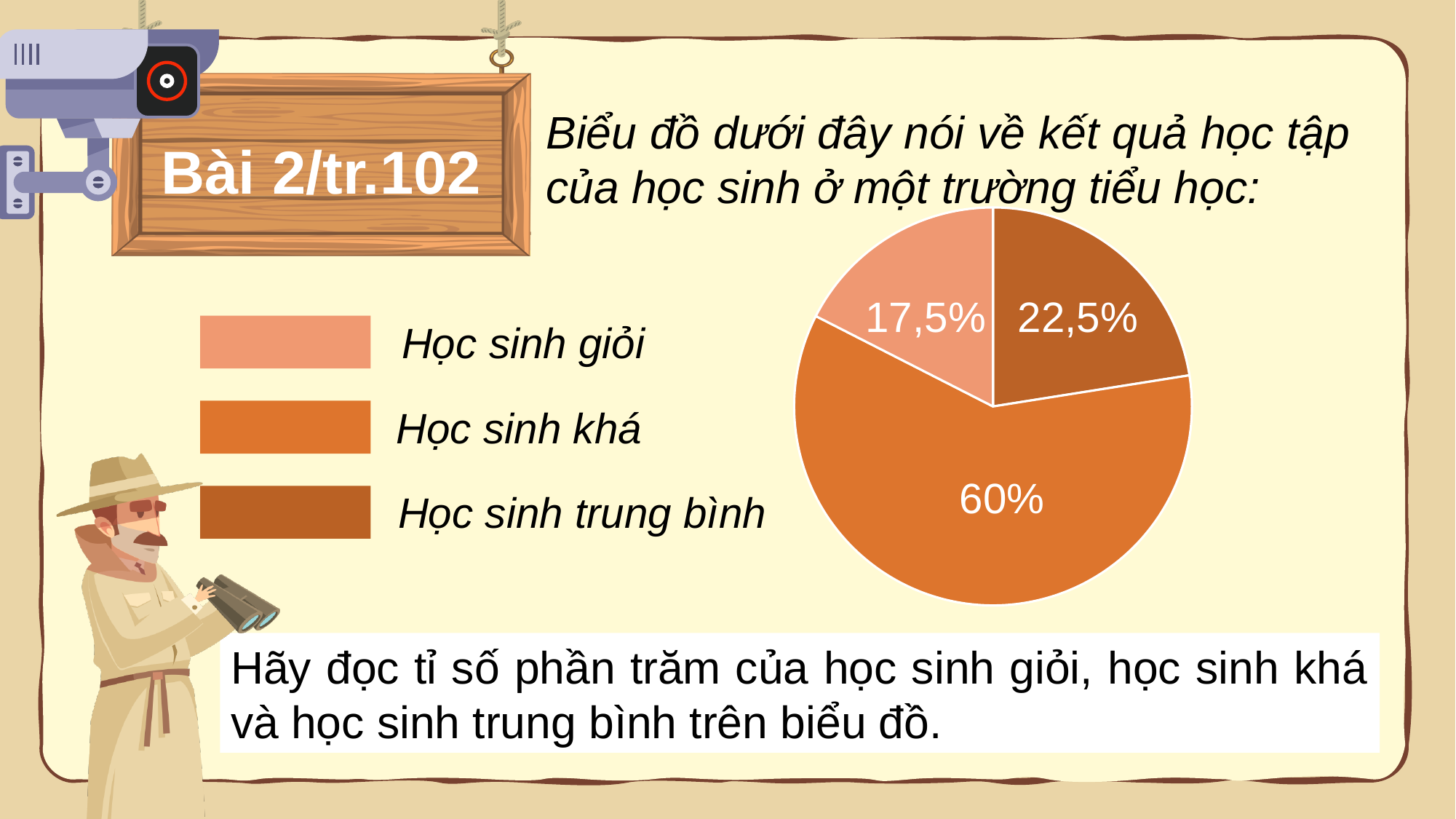
What percentage of the pie chart is for Học sinh giỏi? 17,5% What is the difference between the percentages for Học sinh khá and Học sinh trung bình? 37,5% What kind of chart is shown on the slide? pie chart Which category has the largest slice of the pie chart? Học sinh khá What percentage of the pie chart is for Học sinh khá? 60% What percentage of the pie chart is for Học sinh trung bình? 22,5% Which category has the smallest slice of the pie chart? Học sinh giỏi How many entries does the legend list? 3 What is the difference between the percentages for Học sinh trung bình and Học sinh giỏi? 5% How many slices does the pie chart have? 3 Which is larger, the slice for Học sinh giỏi or the slice for Học sinh trung bình? Học sinh trung bình Which legend entry is shown with the lightest colour? Học sinh giỏi